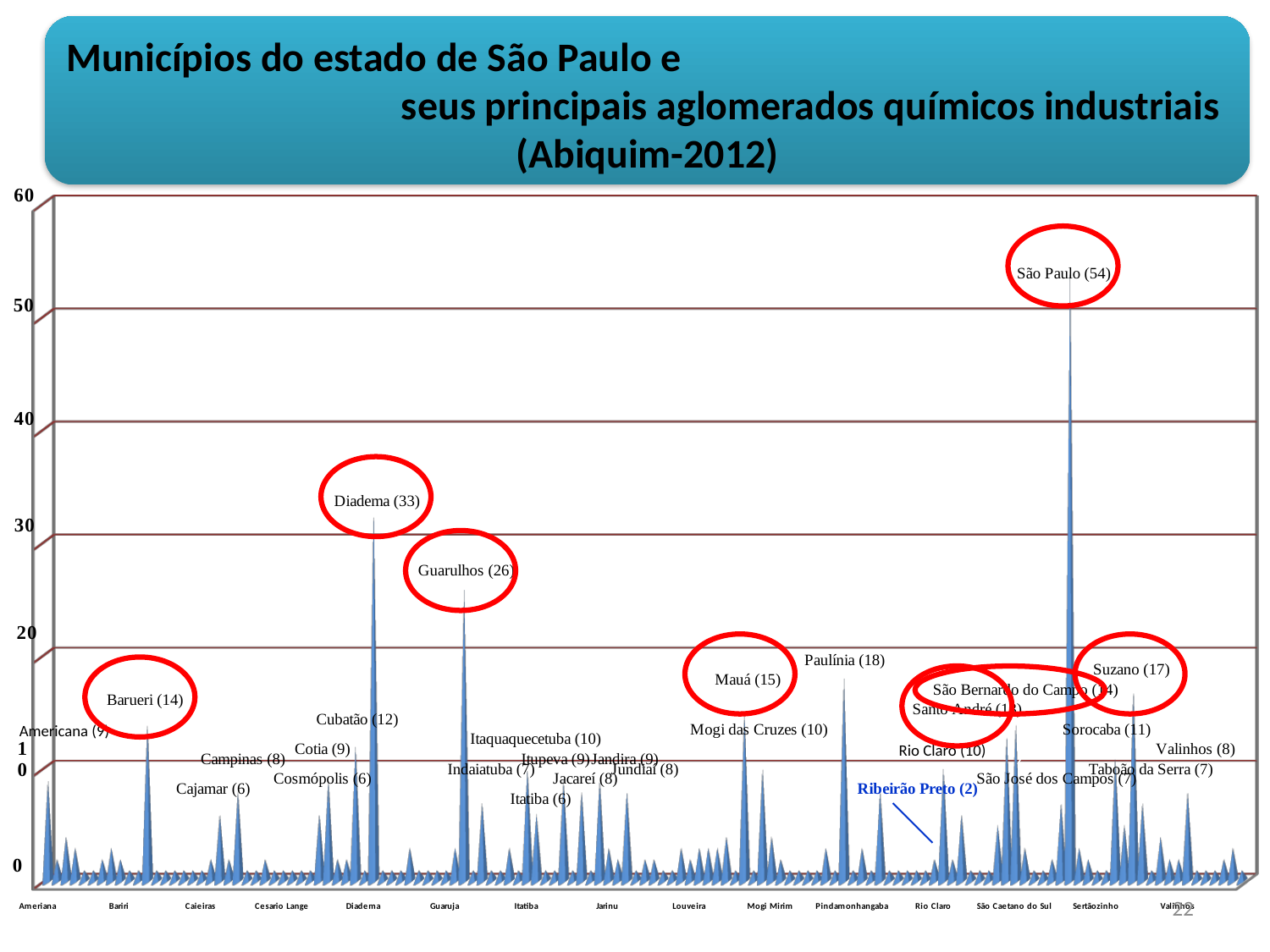
What value is shown for Paulínia? 18 What value is shown for Guarulhos? 26 Is the value for São Paulo greater or less than 50? greater Which has a larger value, Mauá or Paulínia? Paulínia What is the difference between the values for São Paulo and Diadema? 21 What kind of chart is shown on the slide? bar chart What value is shown for Ribeirão Preto? 2 What is the difference between the values for Diadema and Guarulhos? 7 Which municipality has the highest value on the chart? São Paulo What value is shown for São Paulo? 54 Which municipality's label is printed in blue on the chart? Ribeirão Preto (2) What value is shown for Diadema? 33